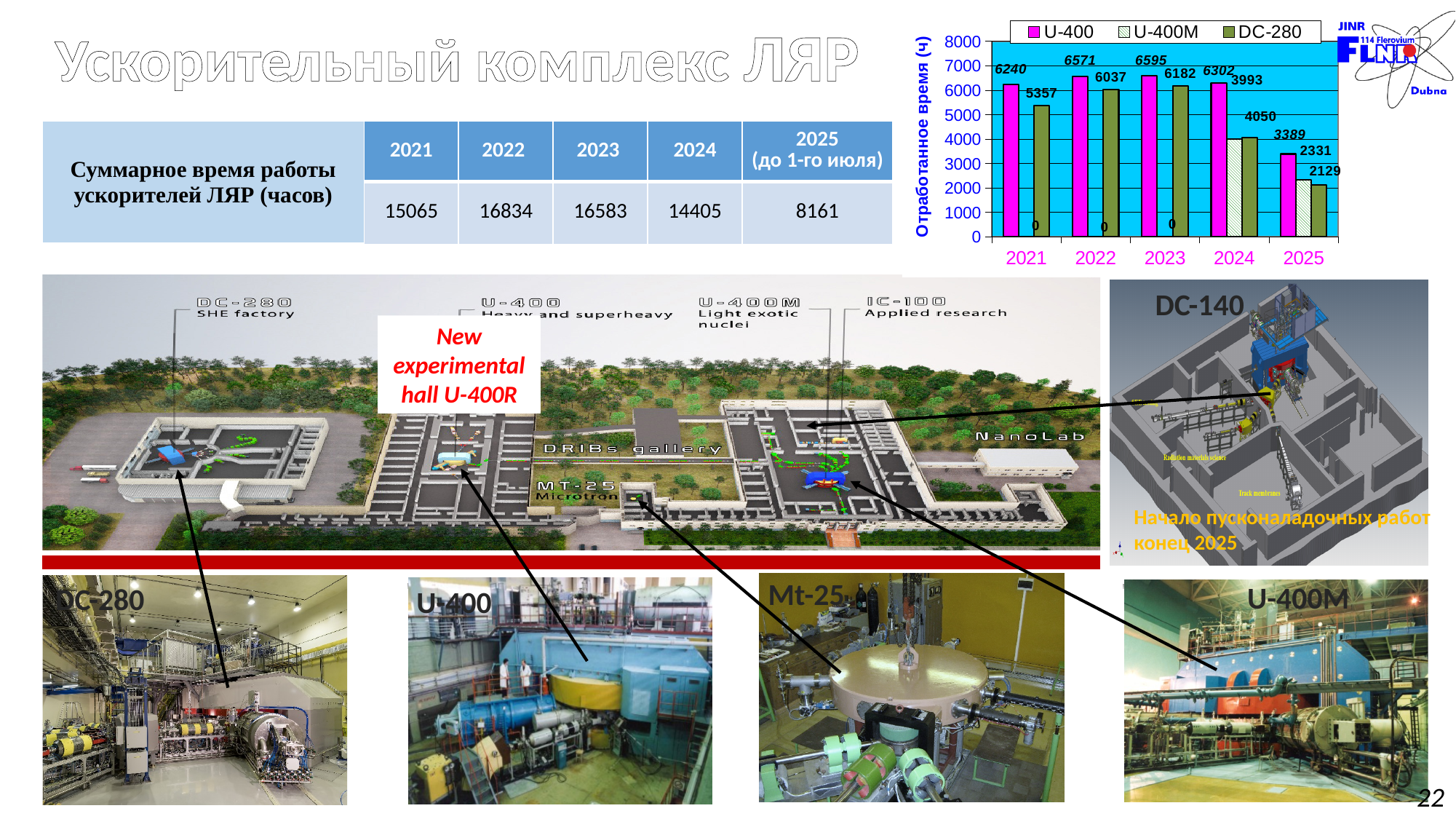
How many years are shown on the x axis of the bar chart? 5 In the bar chart, what is the value for U-400 in 2023? 6595 How many series does the legend of the bar chart list? 3 In the bar chart, what is the value for U-400 in 2025? 3389 What is the label of the y axis of the bar chart? Отработанное время (ч) In the bar chart, which is larger in 2024: the U-400 value or the DC-280 value? U-400 In the bar chart, what is the value for U-400M in 2024? 3993 In the bar chart, which year has the lowest value for DC-280? 2025 In the bar chart, which year has the highest value for U-400? 2023 What kind of chart is shown in the top right of the slide? bar chart In the bar chart, what is the value for DC-280 in 2021? 5357 In the bar chart, what is the difference between the U-400 and DC-280 values in 2022? 534